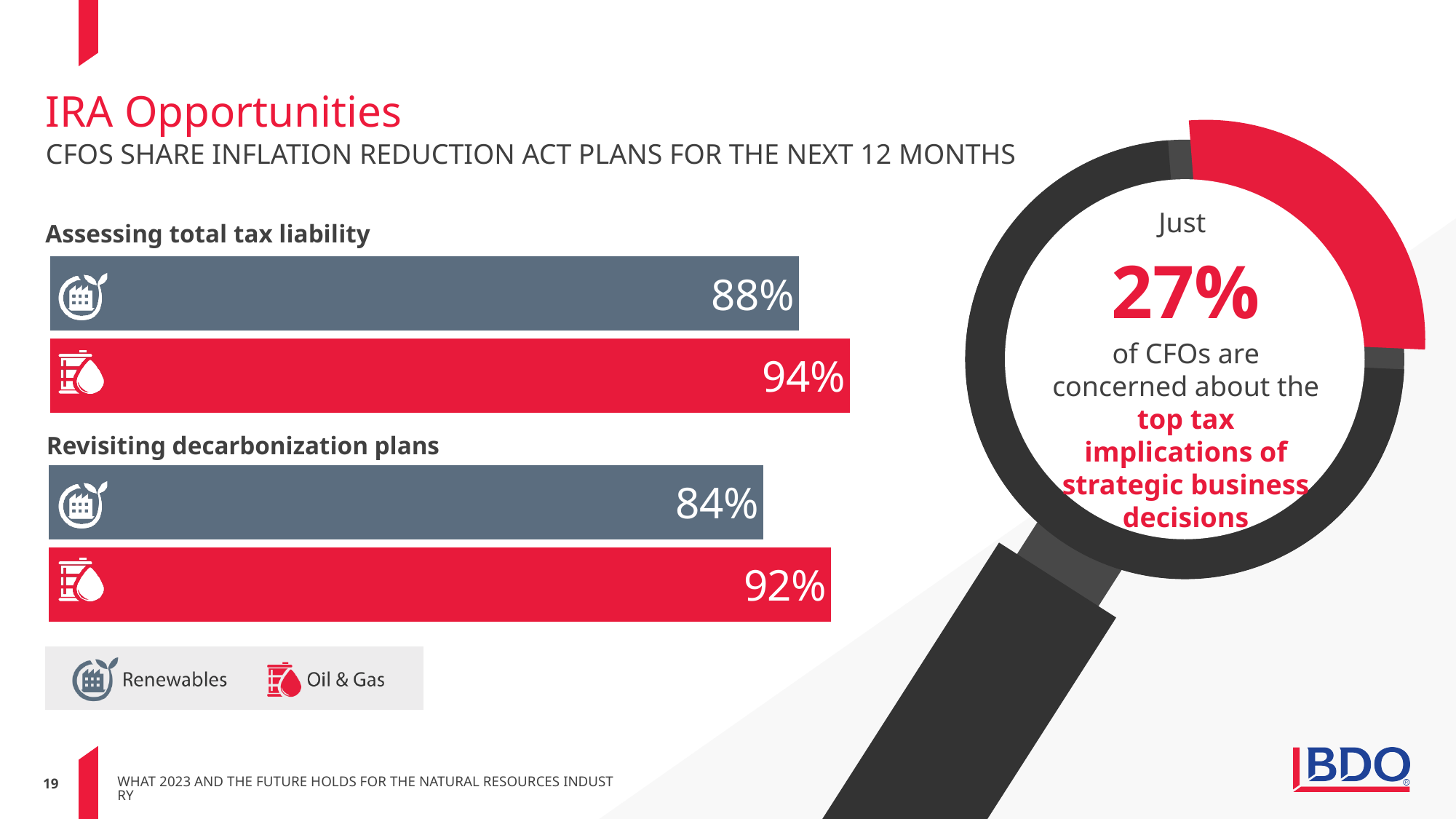
In the 'Assessing total tax liability' chart, which sector has the higher value? Oil & Gas In the 'Assessing total tax liability' chart, what is the value for Oil & Gas? 94% Is the Renewables value for 'Assessing total tax liability' larger or smaller than the Renewables value for 'Revisiting decarbonization plans'? larger In the 'Revisiting decarbonization plans' chart, what is the value for Renewables? 84% In the 'Revisiting decarbonization plans' chart, what is the value for Oil & Gas? 92% In the 'Revisiting decarbonization plans' chart, which sector has the lower value? Renewables How many sectors does the legend below the bar charts list? 2 In the 'Assessing total tax liability' chart, what is the difference between the Oil & Gas and Renewables values? 6% What type of chart is used to show the 'Assessing total tax liability' and 'Revisiting decarbonization plans' data? bar chart What percentage is shown in the ring chart inside the magnifying glass on the right of the slide? 27% In the 'Assessing total tax liability' chart, what is the value for Renewables? 88% In the 'Revisiting decarbonization plans' chart, what is the difference between the Oil & Gas and Renewables values? 8%